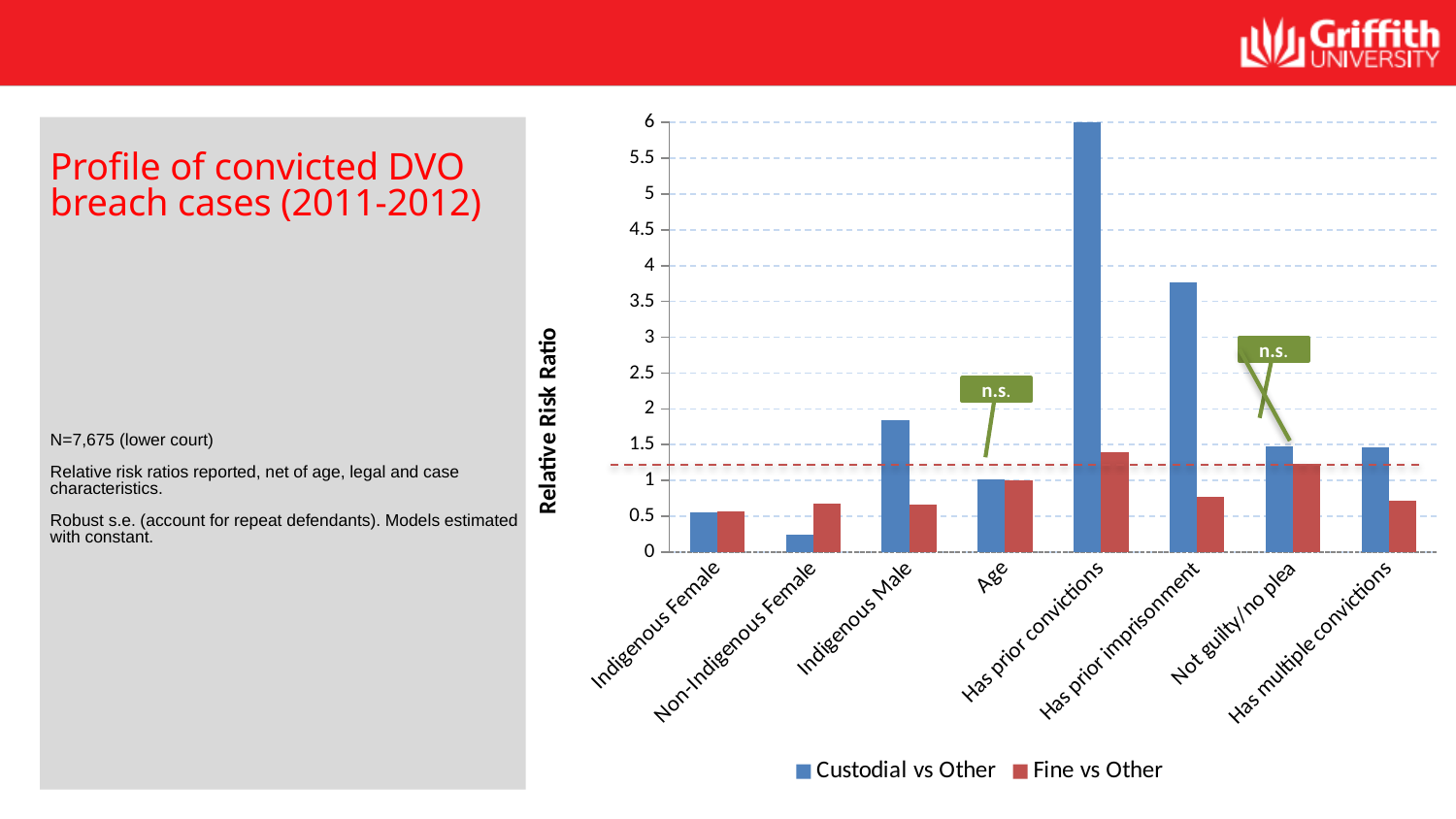
Which category has the highest Custodial vs Other value? Has prior convictions Is the Custodial vs Other value for Non-Indigenous Female greater or less than 0.5? less How many categories are shown along the x axis of the chart? 8 Is the Fine vs Other value for Has prior imprisonment greater or less than 1? less How many series does the chart's legend list? 2 For Non-Indigenous Female, which is larger: Custodial vs Other or Fine vs Other? Fine vs Other What is the label on the chart's vertical axis? Relative Risk Ratio For Indigenous Male, which is larger: Custodial vs Other or Fine vs Other? Custodial vs Other What kind of chart is shown on the slide? Bar chart Is the Custodial vs Other value for Has prior imprisonment greater or less than 3? greater Which category has the lowest Custodial vs Other value? Non-Indigenous Female